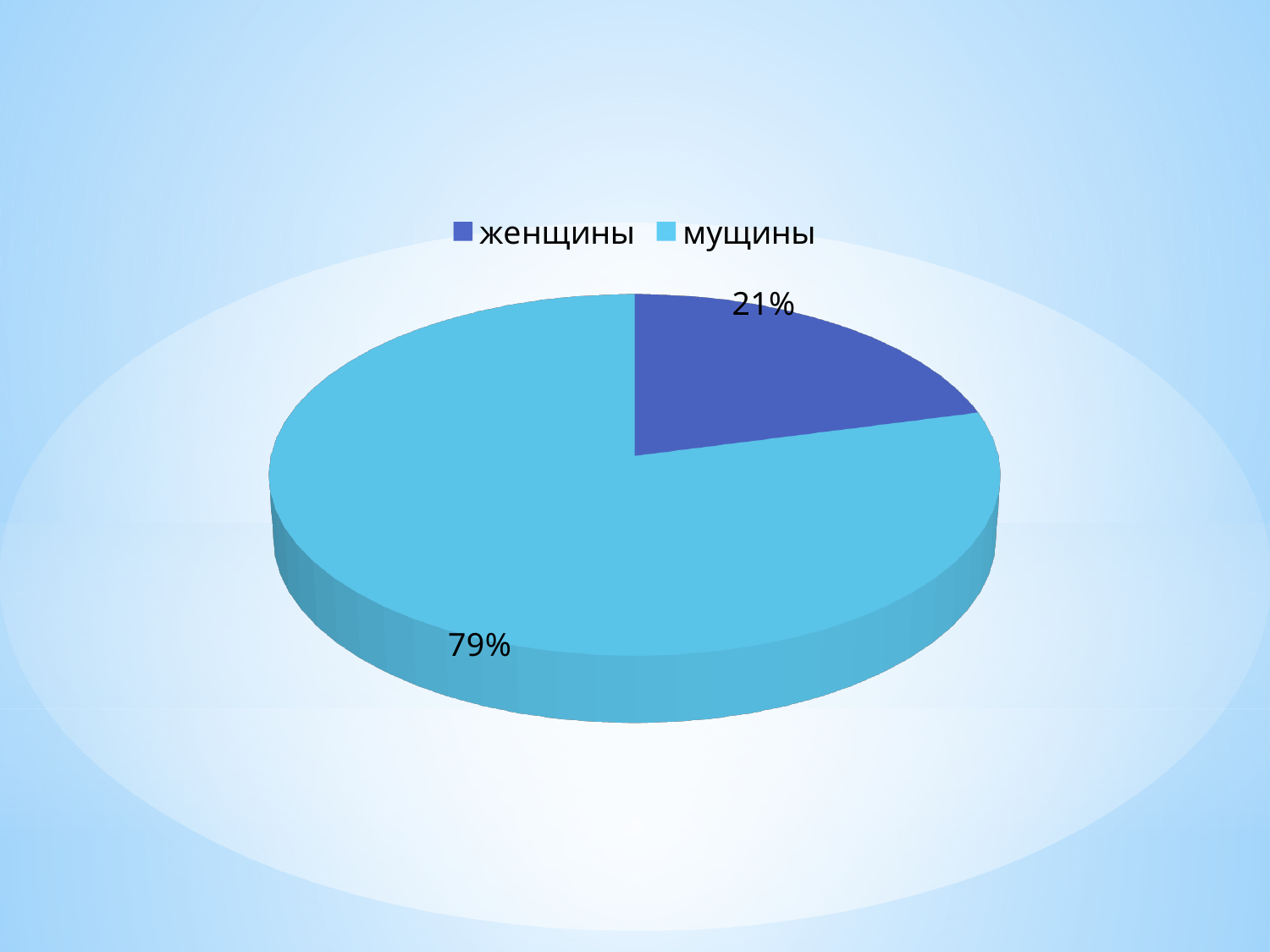
What kind of chart is shown on the slide? pie chart What is the difference in percentage points between the мущины slice and the женщины slice? 58 What share of the pie does мущины represent? 79% What colour is the женщины slice in the pie chart? dark blue Is the share for женщины greater or less than 50%? less What colour is the мущины slice in the pie chart? light blue Which slice is larger, женщины or мущины? мущины How many entries does the legend list? 2 How many slices does the pie chart have? 2 What share of the pie does женщины represent? 21% Which category has the largest slice of the pie? мущины Which category has the smallest slice of the pie? женщины